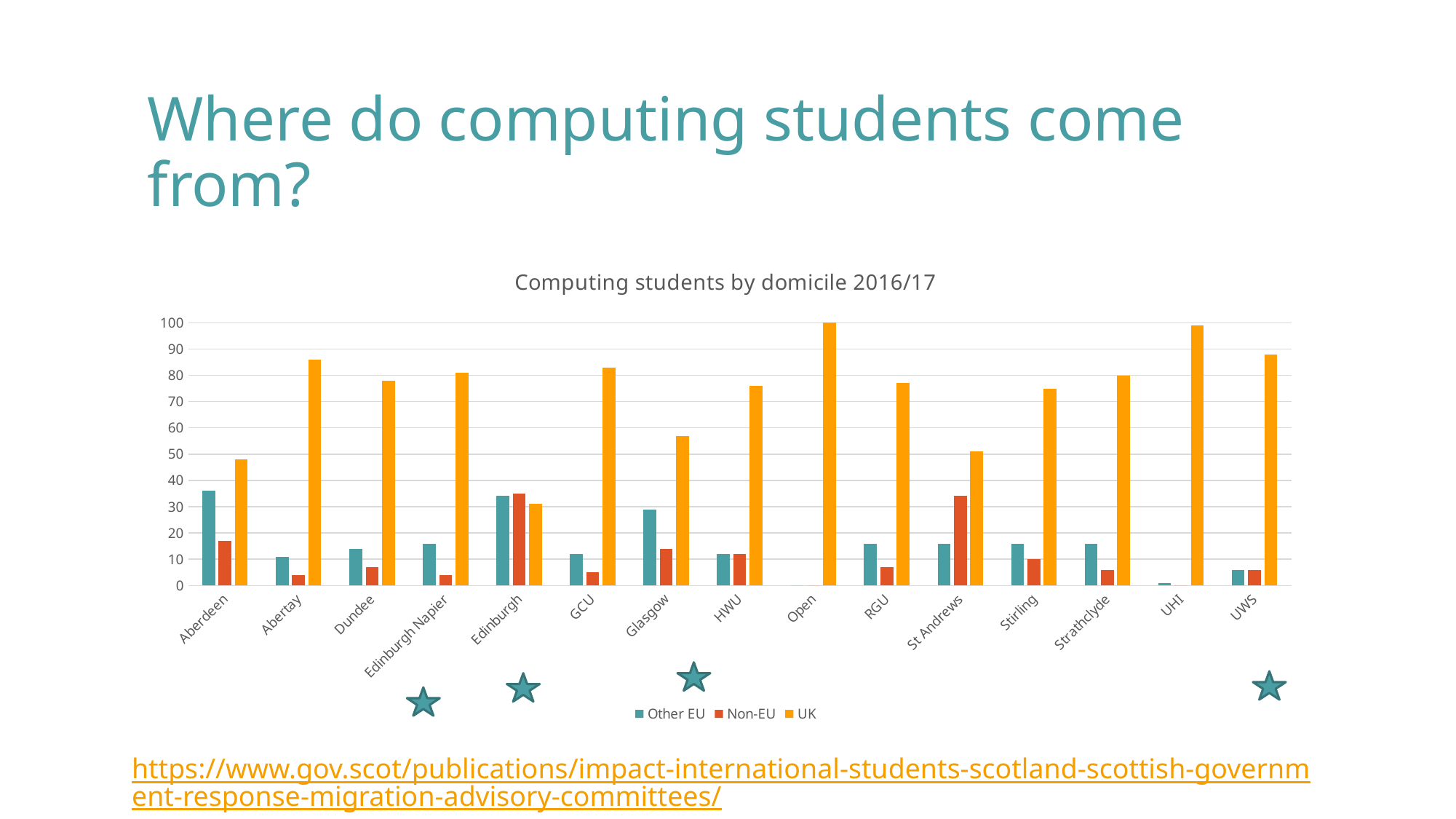
What kind of chart is shown on the slide? bar chart Is the UK value for Glasgow greater or less than 50? greater For Glasgow, which is larger, the Other EU value or the Non-EU value? Other EU Is the UK value for Edinburgh greater or less than 40? less Is the Non-EU value for St Andrews greater or less than 30? greater How many series does the legend list? 3 How many universities are shown on the x axis? 15 Which series is shown in orange? UK Which is larger, the UK value for Aberdeen or the UK value for Abertay? Abertay What is the title of the chart? Computing students by domicile 2016/17 Which university has the lowest UK value? Edinburgh